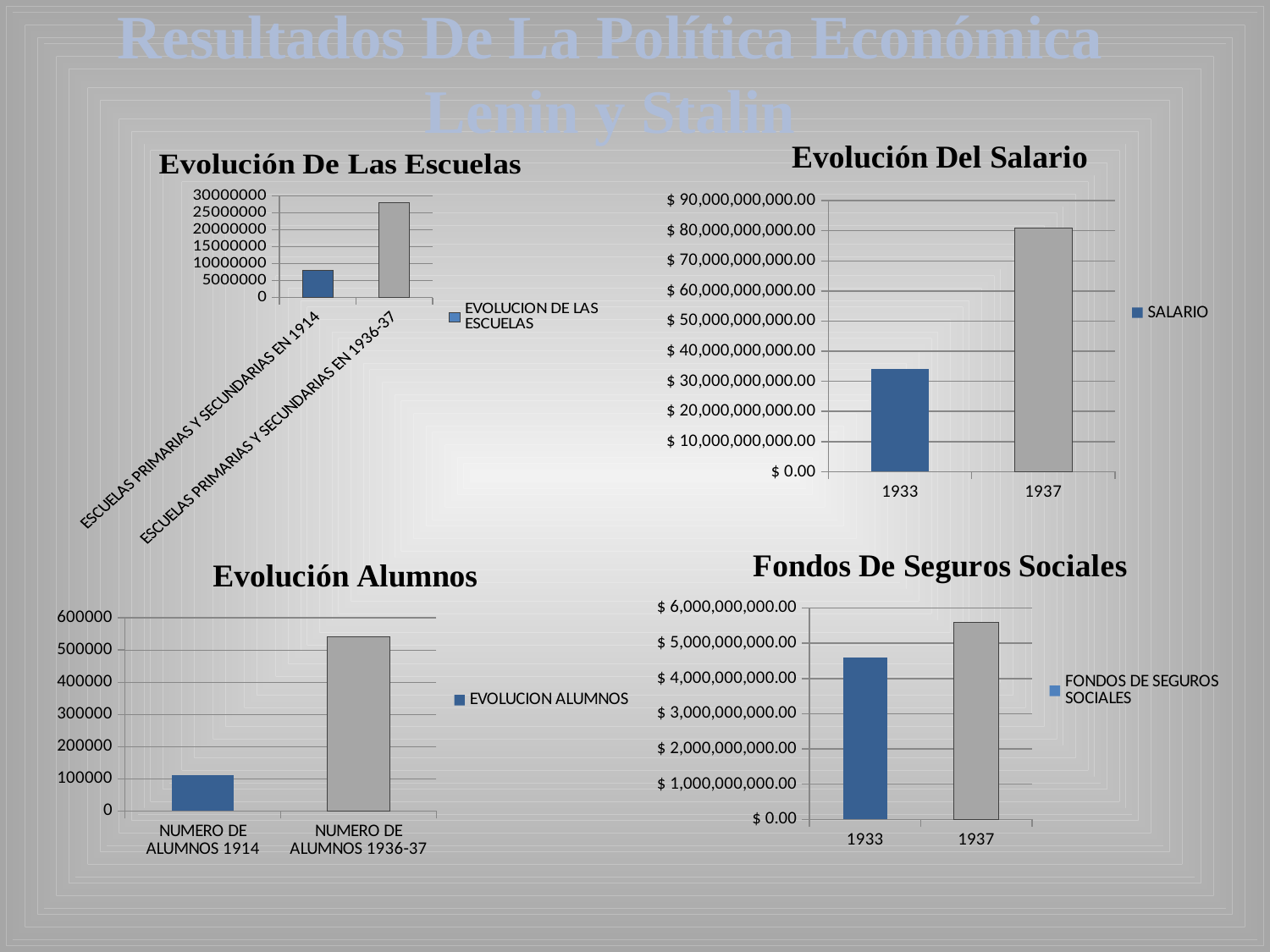
In the 'Evolución Del Salario' chart, is the value for 1937 greater or less than $ 70,000,000,000.00? greater In the 'Fondos De Seguros Sociales' chart, is the value for 1933 greater or less than $ 5,000,000,000.00? less In the 'Evolución De Las Escuelas' chart, which category is larger: ESCUELAS PRIMARIAS Y SECUNDARIAS EN 1914 or ESCUELAS PRIMARIAS Y SECUNDARIAS EN 1936-37? ESCUELAS PRIMARIAS Y SECUNDARIAS EN 1936-37 In the 'Fondos De Seguros Sociales' chart, is the value for 1937 greater or less than $ 5,000,000,000.00? greater In the 'Evolución Del Salario' chart, which year has the higher salary value? 1937 What kind of chart is 'Evolución Alumnos'? bar chart How many charts are shown on the slide? 4 In the 'Fondos De Seguros Sociales' chart, which year has the lower value? 1933